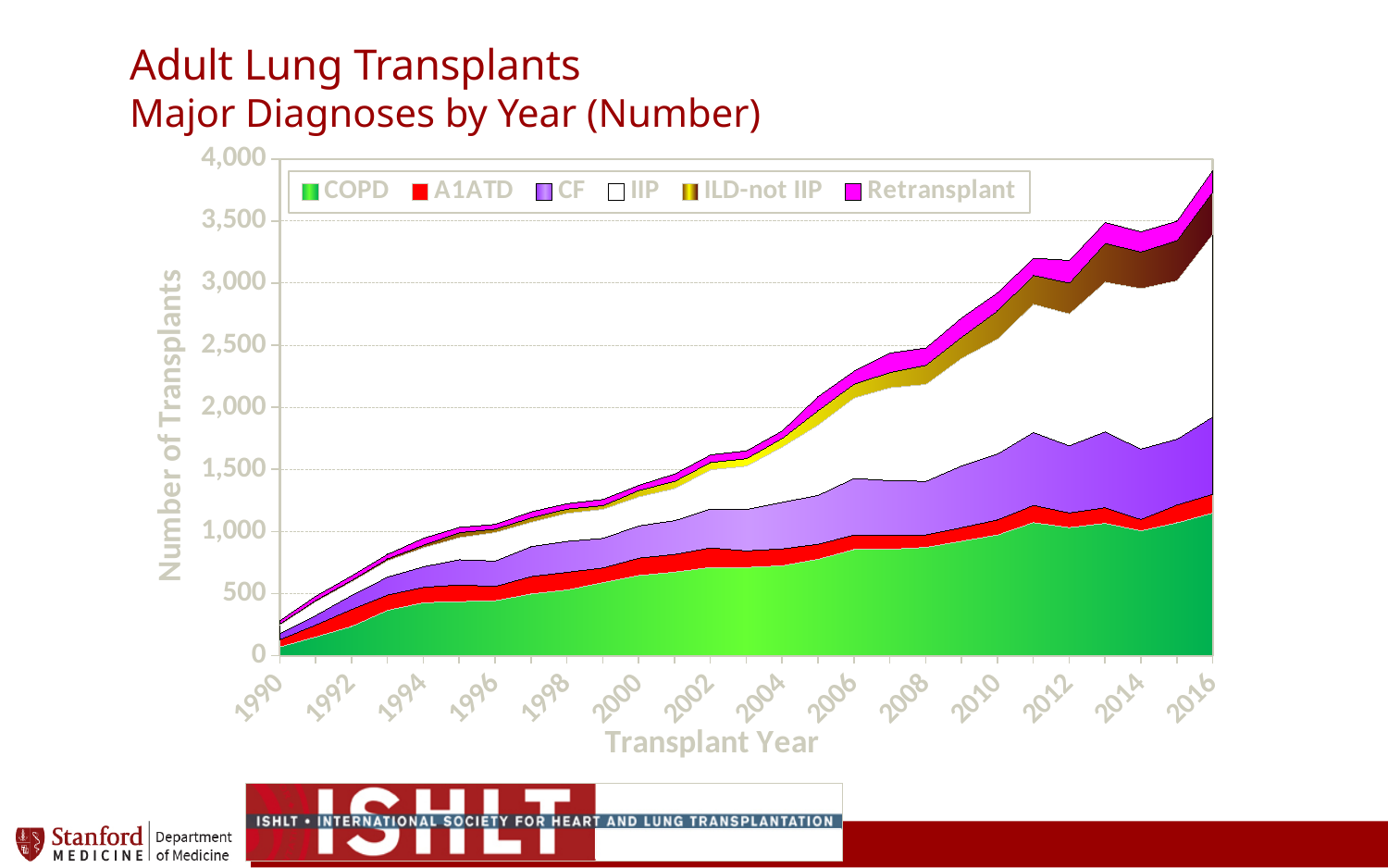
Is the total number of transplants in 1990 greater or less than 500? less Which year has the highest total number of transplants? 2016 Which year has the lowest total number of transplants? 1990 What kind of chart is shown on the slide? Stacked area chart Is the total number of transplants in 2016 greater or less than 3,500? greater What is the title of the chart? Adult Lung Transplants Major Diagnoses by Year (Number) How many series does the legend list? 6 Do the total number of transplants rise or fall from 1990 to 2016? Rise Is the number of COPD transplants in 2016 greater or less than 1,000? greater What is the label of the y axis? Number of Transplants In 2016, which diagnosis accounts for more transplants, COPD or A1ATD? COPD